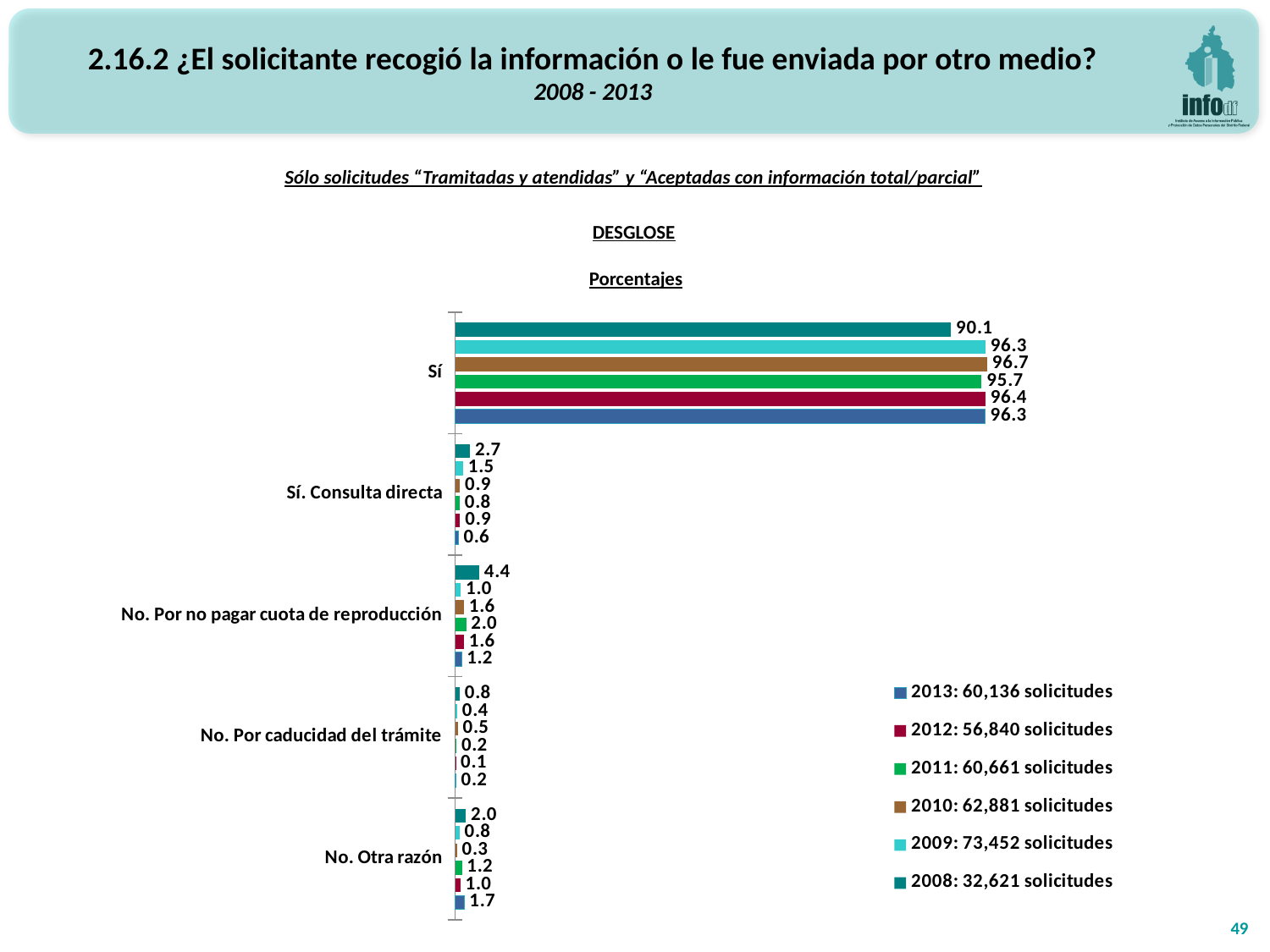
How many series does the legend list? 6 Which is larger for 'No. Otra razón': the 2013 value or the 2012 value? 2013 What is the value for 'Sí' in 2013? 96.3 What is the value for 'No. Por no pagar cuota de reproducción' in 2008? 4.4 What is the difference between the 2008 and 2009 values for 'No. Por no pagar cuota de reproducción'? 3.4 According to the legend, how many solicitudes were there in 2009? 73,452 How many categories are shown on the chart? 5 Which year has the highest value for 'Sí. Consulta directa'? 2008 What is the difference between the 2010 and 2008 values for 'Sí'? 6.6 What is the value for 'No. Otra razón' in 2011? 1.2 What type of chart is shown on the slide? bar chart Which year has the lowest value for 'Sí'? 2008